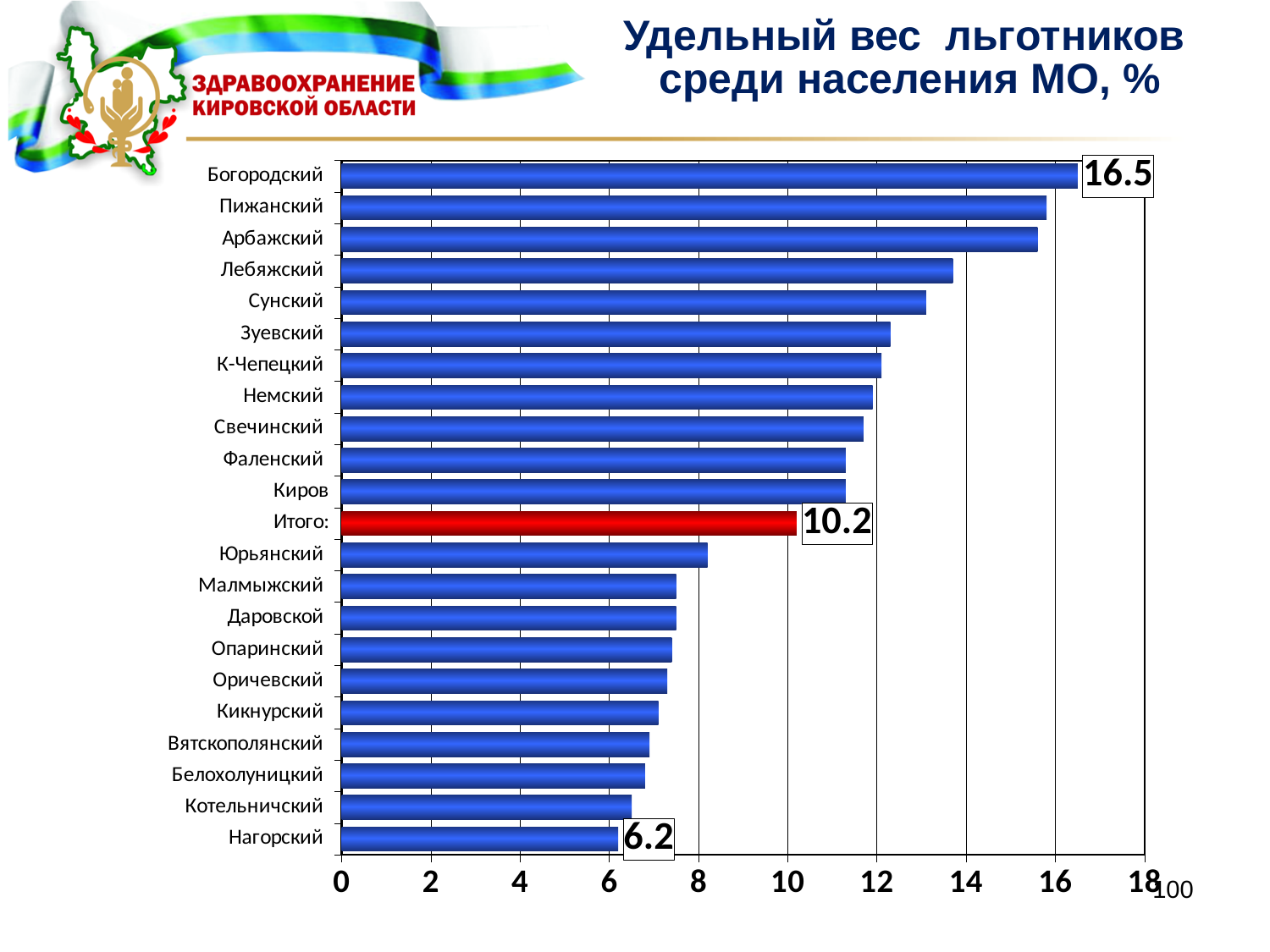
How many categories are shown on the chart? 22 Which is larger, the value for Пижанский or the value for Юрьянский? Пижанский What is the value for Итого:? 10.2 What is the value for Богородский? 16.5 What is the value for Нагорский? 6.2 What is the difference between the values for Богородский and Нагорский? 10.3 Which category has the highest value? Богородский What is the difference between the values for Богородский and Итого:? 6.3 Is the value for Юрьянский greater or less than 10? less What kind of chart is shown on the slide? bar chart Which category has the lowest value? Нагорский Is the value for Лебяжский greater or less than 12? greater